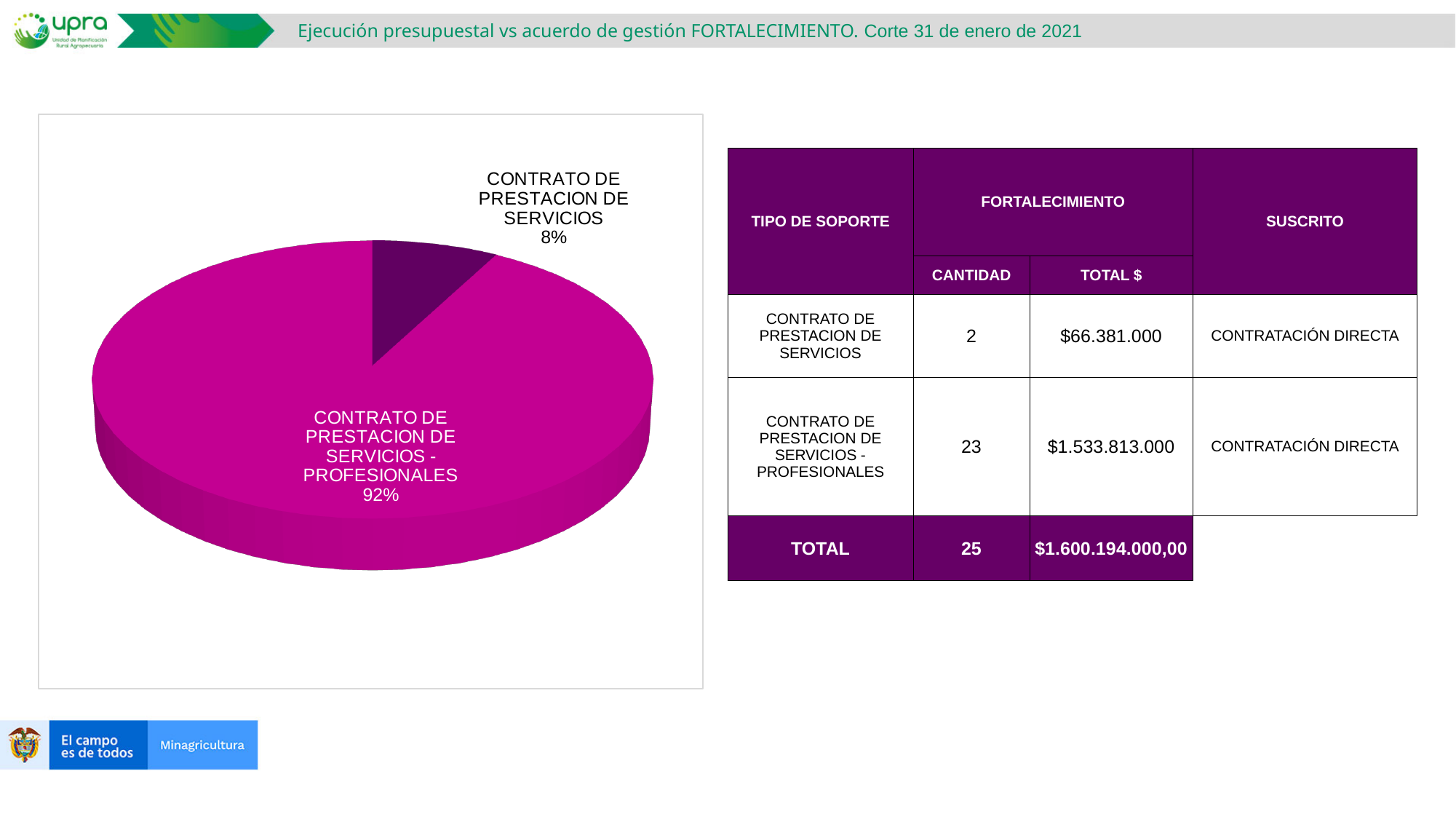
Which slice of the pie chart is the largest? CONTRATO DE PRESTACION DE SERVICIOS - PROFESIONALES What colour is the CONTRATO DE PRESTACION DE SERVICIOS - PROFESIONALES slice of the pie chart? Magenta Is the share for CONTRATO DE PRESTACION DE SERVICIOS greater or less than 10%? less How many slices does the pie chart have? 2 What is the difference in percentage points between the CONTRATO DE PRESTACION DE SERVICIOS - PROFESIONALES slice and the CONTRATO DE PRESTACION DE SERVICIOS slice? 84 percentage points What share of the pie does CONTRATO DE PRESTACION DE SERVICIOS represent? 8% Which is larger in the pie chart: CONTRATO DE PRESTACION DE SERVICIOS or CONTRATO DE PRESTACION DE SERVICIOS - PROFESIONALES? CONTRATO DE PRESTACION DE SERVICIOS - PROFESIONALES Is the share for CONTRATO DE PRESTACION DE SERVICIOS - PROFESIONALES greater or less than 90%? greater Does the pie chart have a legend? No What kind of chart is shown on the slide? Pie chart What share of the pie does CONTRATO DE PRESTACION DE SERVICIOS - PROFESIONALES represent? 92% Which slice of the pie chart is the smallest? CONTRATO DE PRESTACION DE SERVICIOS